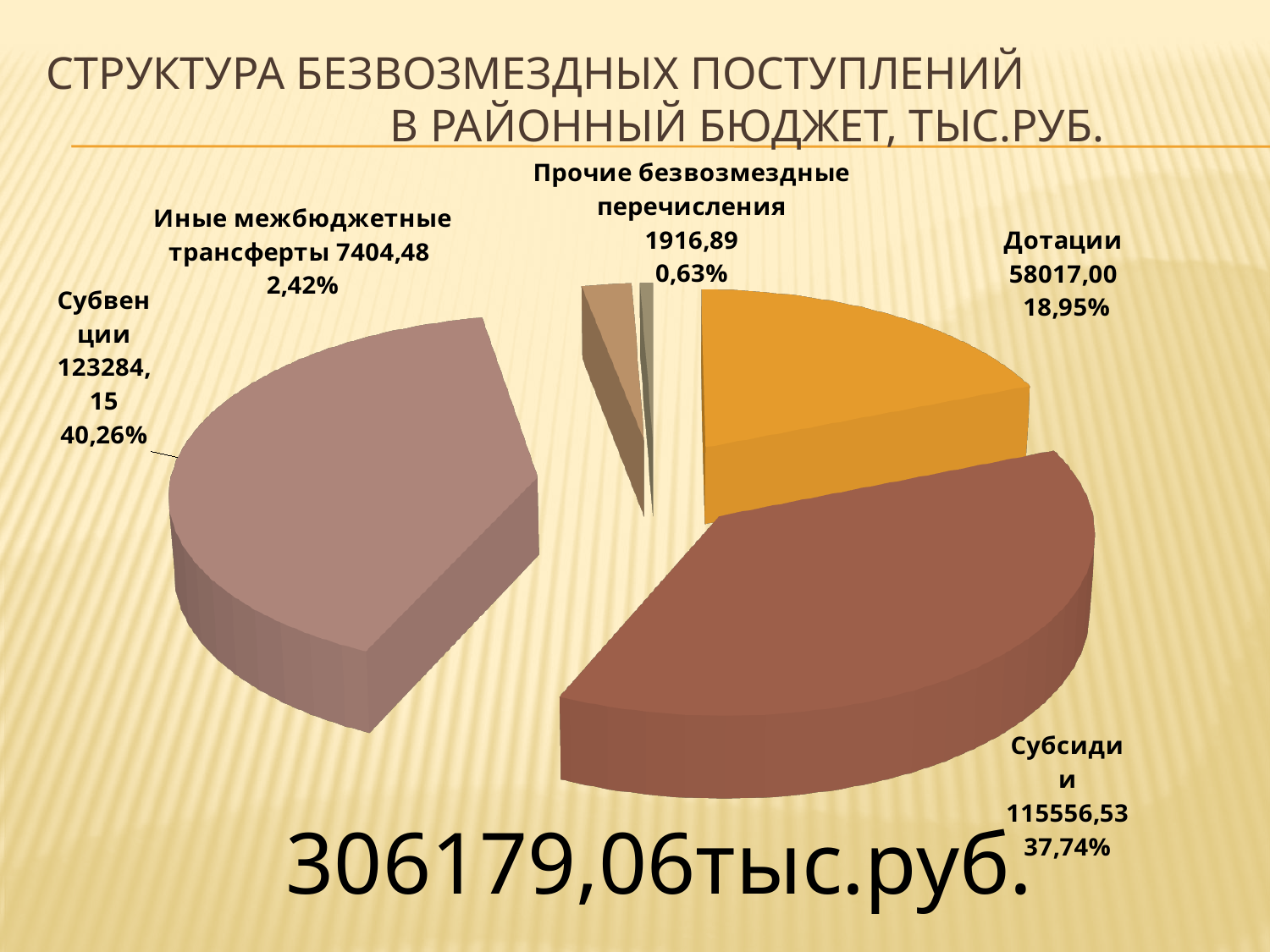
Which is larger, Субсидии or Дотации? Субсидии What share of the pie does Субвенции represent? 40,26% What total amount in тыс.руб. is printed on the slide? 306179,06тыс.руб. What is the value for Дотации? 58017,00 How many slices does the pie chart have? 5 What is the value for Субсидии? 115556,53 What kind of chart is shown on the slide? pie chart What is the value for Прочие безвозмездные перечисления? 1916,89 What is the value for Иные межбюджетные трансферты? 7404,48 What share of the pie does Дотации represent? 18,95% Which category has the smallest slice? Прочие безвозмездные перечисления Which category has the largest slice? Субвенции